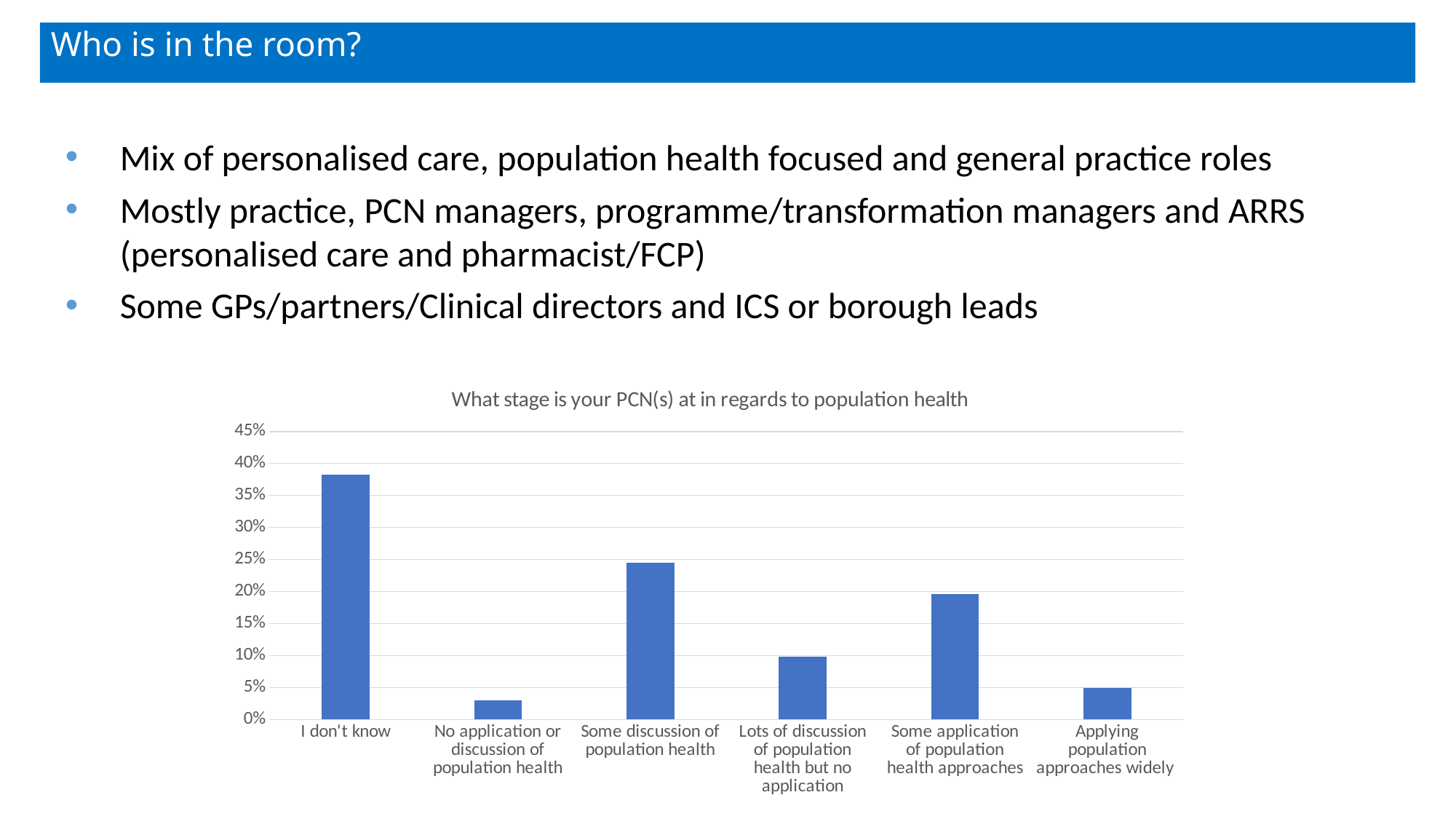
Is the value for 'Lots of discussion of population health but no application' greater or less than 15%? less How many categories are shown on the x axis of the chart? 6 Which category has the highest value in the chart? I don't know Is the value for 'No application or discussion of population health' greater or less than 5%? less Is the value for 'I don't know' greater or less than 40%? less What type of chart is shown on the slide? bar chart Which is larger: the value for 'Some discussion of population health' or 'Some application of population health approaches'? Some discussion of population health What colour are the bars in the chart? blue Which category has the lowest value in the chart? No application or discussion of population health What is the title of the chart? What stage is your PCN(s) at in regards to population health